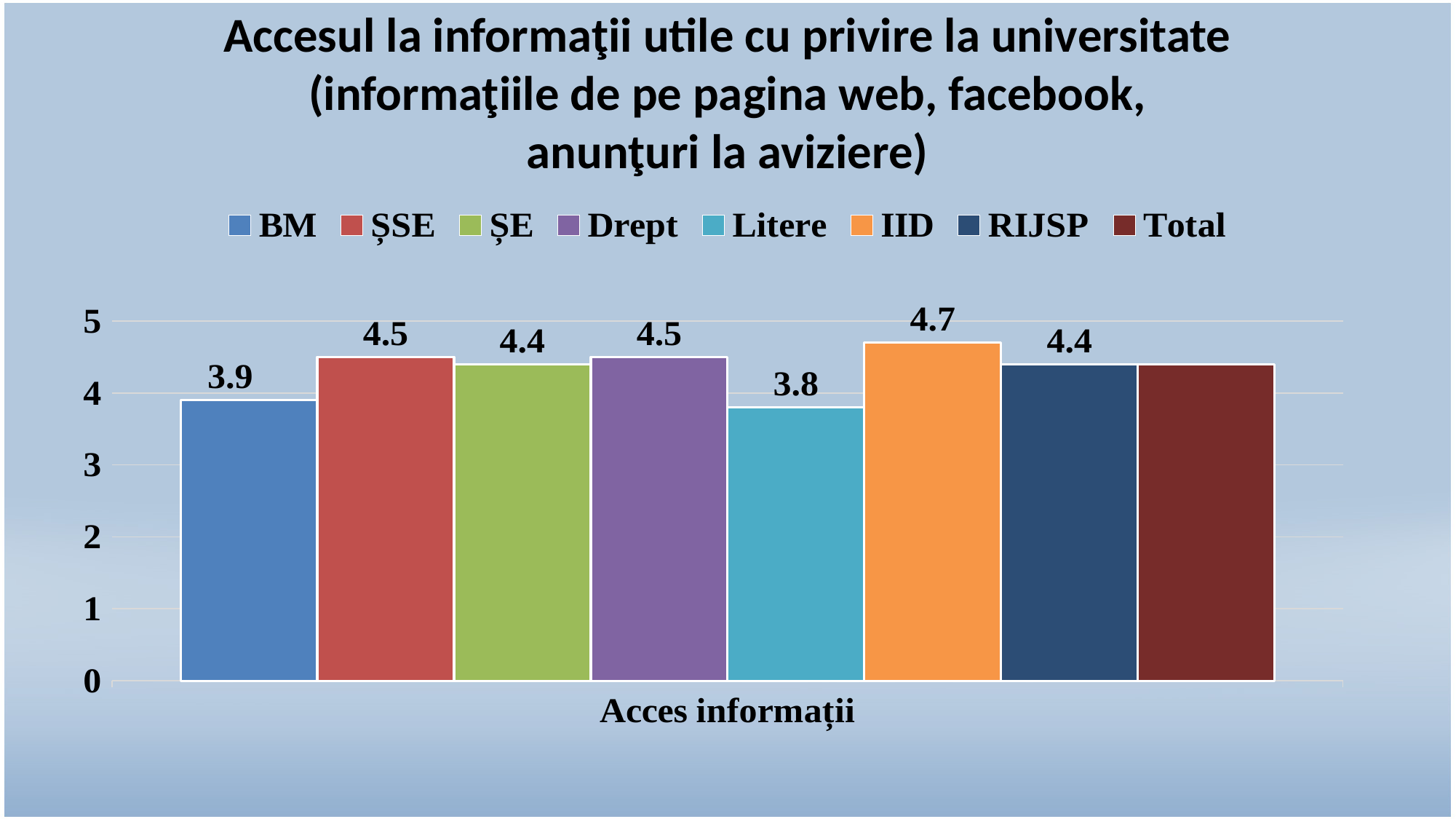
What is the value for Litere? 3.8 What is the value for Total? 4.4 How many series does the legend list? 8 What is the label on the x axis of the chart? Acces informații Which series has the highest value? IID What is the difference between the values for ȘSE and BM? 0.6 Which series has the lowest value? Litere Which is larger, the value for Drept or the value for BM? Drept What is the value for BM? 3.9 What is the difference between the values for IID and Litere? 0.9 What kind of chart is shown on the slide? Bar chart What is the value for IID? 4.7